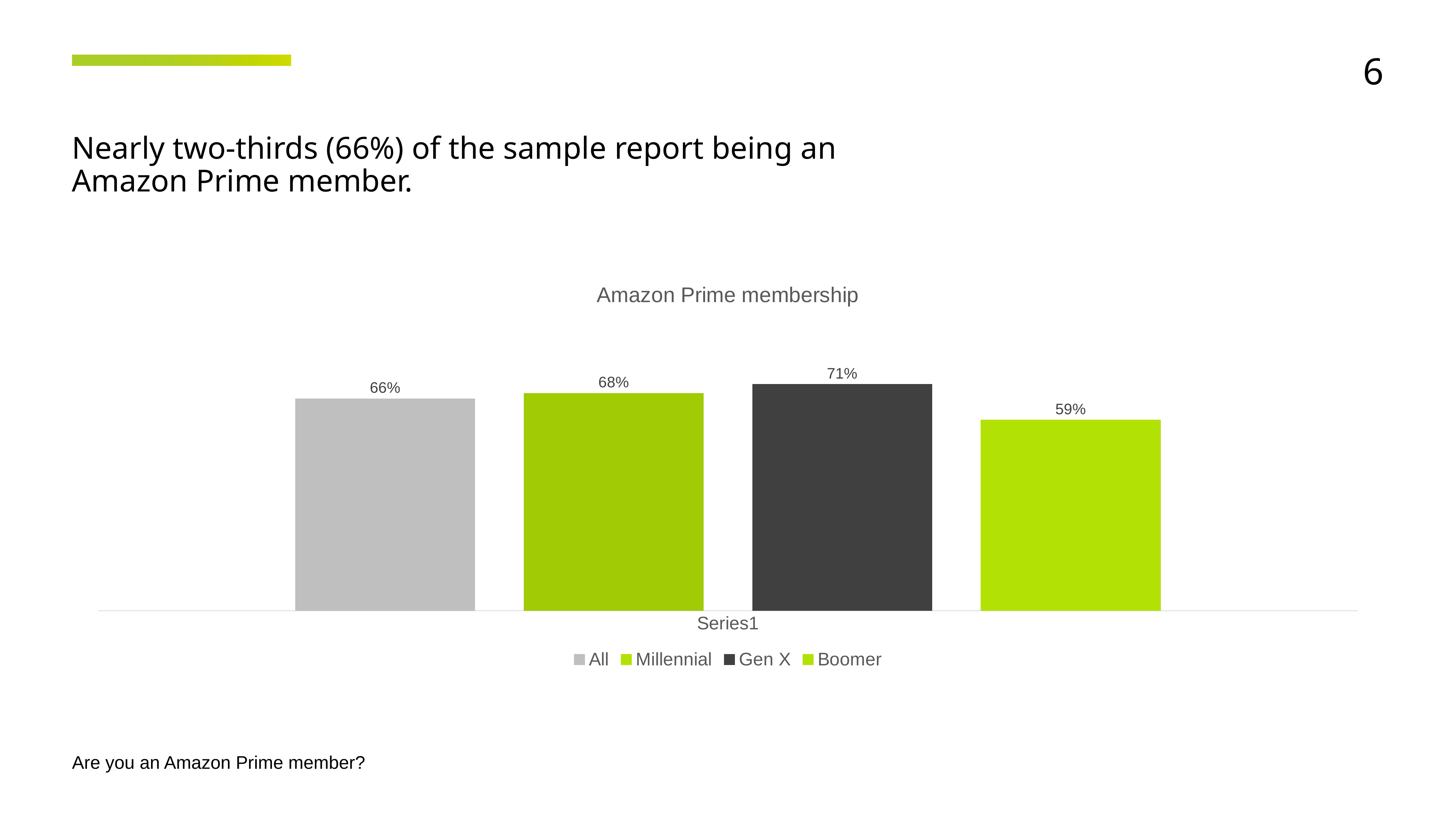
How many series does the legend list? 4 What is the Amazon Prime membership value for Gen X? 71% What is the title of the chart? Amazon Prime membership Which group has the lowest Amazon Prime membership? Boomer What is the Amazon Prime membership value for All? 66% What is the difference between the Millennial and All values? 2% Which is larger, the value for Millennial or the value for Boomer? Millennial What is the Amazon Prime membership value for Boomer? 59% What is the Amazon Prime membership value for Millennial? 68% Which group has the highest Amazon Prime membership? Gen X What kind of chart is shown on the slide? Bar chart What is the difference between the Gen X and Boomer values? 12%